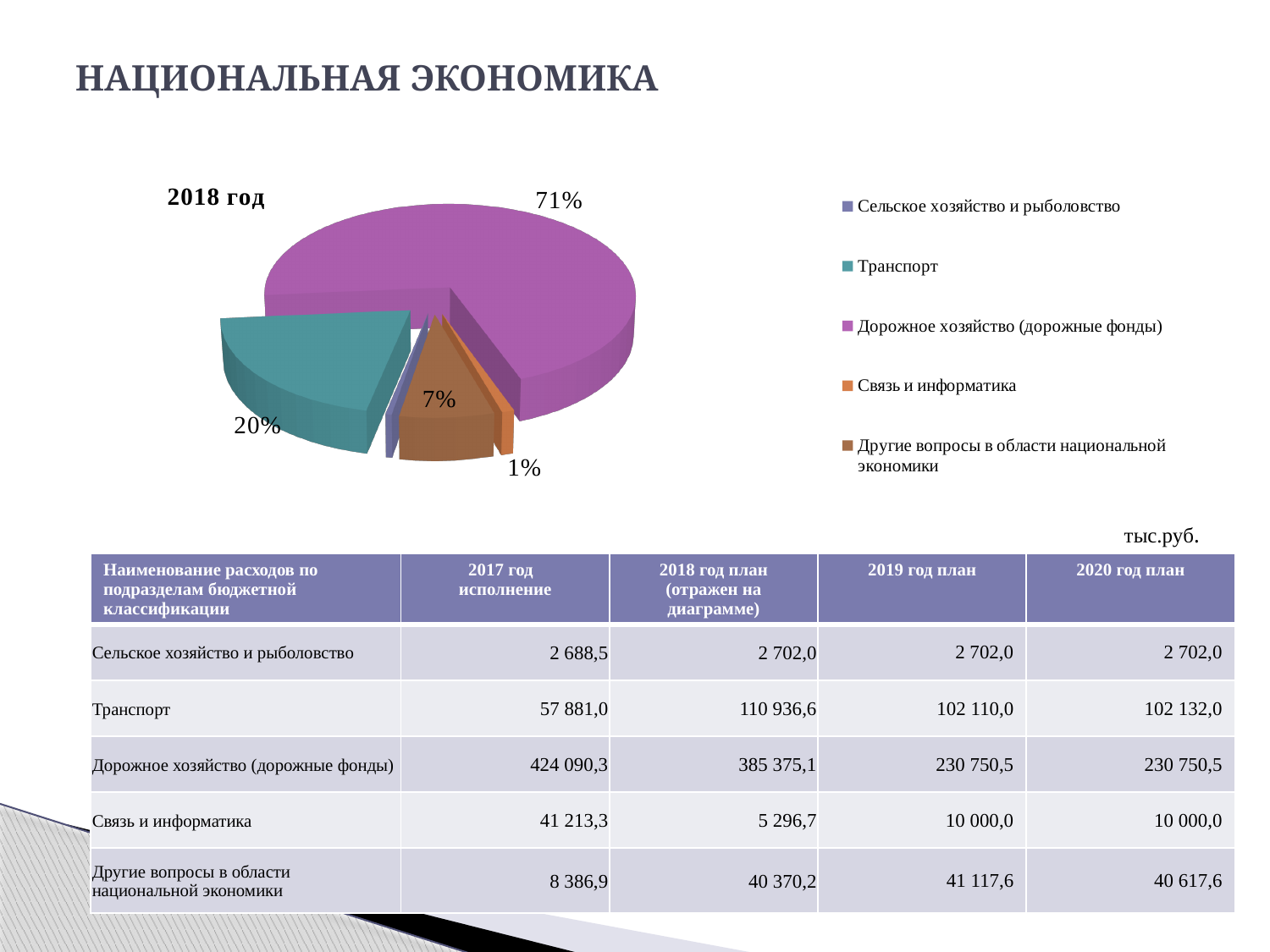
What share of the 2018 год pie chart does Транспорт account for? 20% What share of the 2018 год pie chart does Другие вопросы в области национальной экономики account for? 7% In the 2018 год pie chart, which slice is larger: Транспорт or Другие вопросы в области национальной экономики? Транспорт In the 2018 год pie chart, is the share for Транспорт greater or less than 50%? less In the 2018 год pie chart, what is the difference in percentage points between the Дорожное хозяйство (дорожные фонды) slice and the Транспорт slice? 51% What share of the 2018 год pie chart does Дорожное хозяйство (дорожные фонды) account for? 71% What is the title of the pie chart on the slide? 2018 год Which category has the largest slice in the 2018 год pie chart? Дорожное хозяйство (дорожные фонды) What colour is the Дорожное хозяйство (дорожные фонды) slice in the pie chart? Purple How many categories does the legend of the 2018 год pie chart list? 5 What kind of chart is shown on the slide? Pie chart